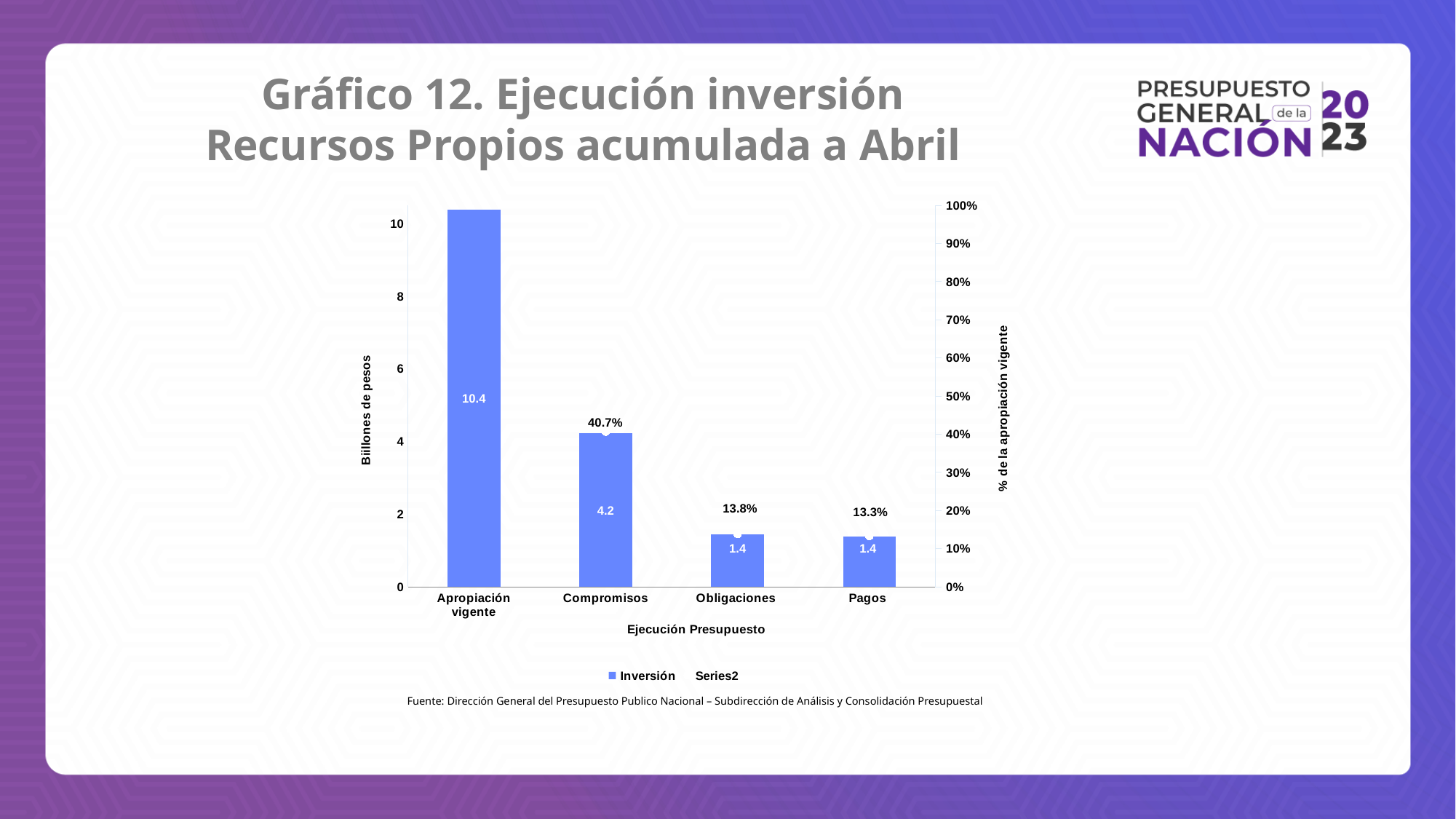
Is the Inversión value for Compromisos greater or less than 6? less How many categories are shown on the x axis? 4 Which is larger, the Inversión value for Compromisos or for Obligaciones? Compromisos How many series does the legend list? 2 What percentage of the apropiación vigente is shown for Obligaciones? 13.8% What kind of chart is shown on the slide? bar chart What percentage of the apropiación vigente is shown for Pagos? 13.3% What is the difference between the Inversión values for Apropiación vigente and Compromisos? 6.2 What is the Inversión value for Compromisos? 4.2 Which category has the highest Inversión value? Apropiación vigente What is the Inversión value for Apropiación vigente? 10.4 What is the label of the left vertical axis? Biillones de pesos